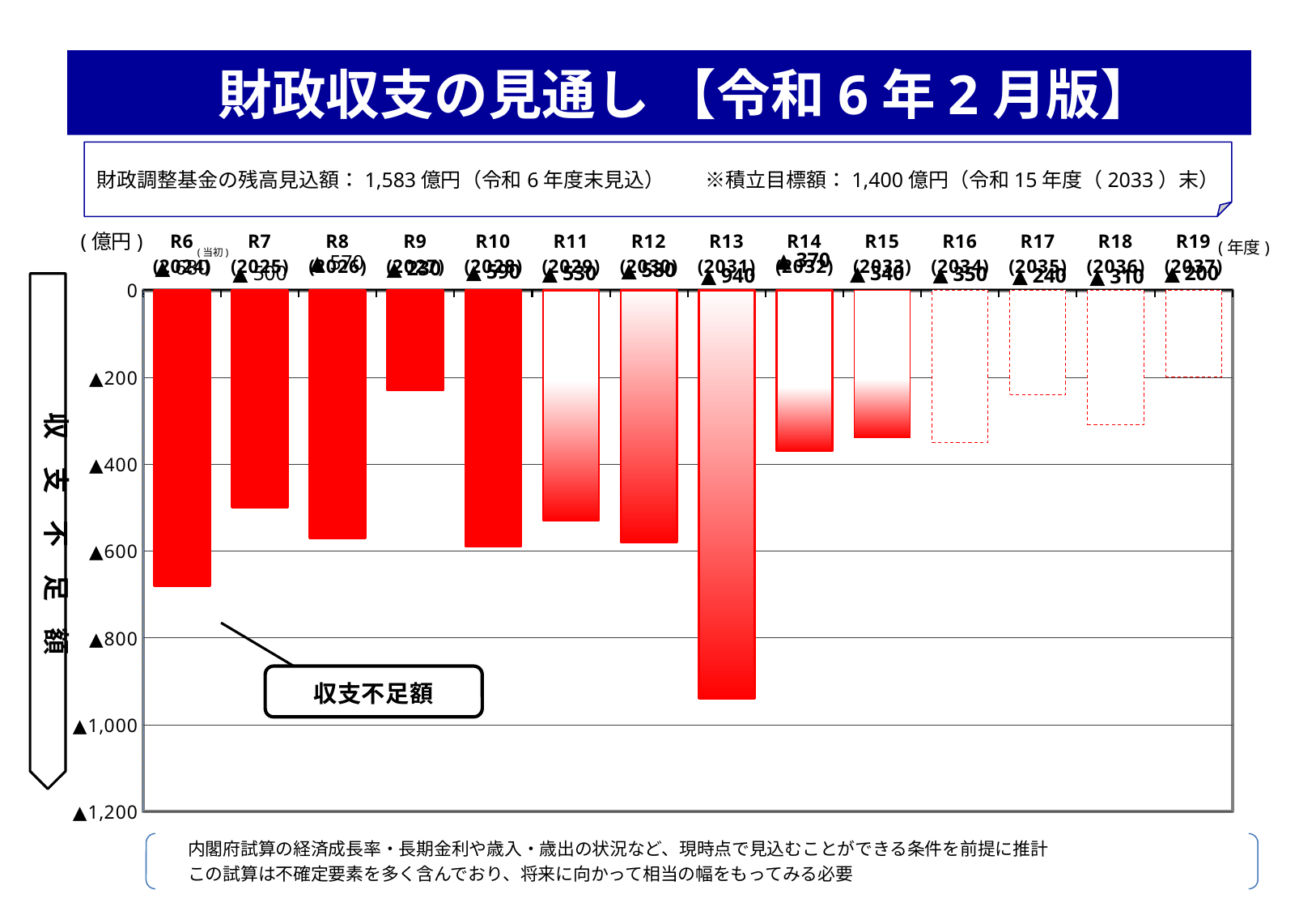
Which fiscal year has the largest shortfall (longest bar)? R13 (2031) What is the value shown for R19 (2037)? ▲200 What is the title of the slide containing the chart? 財政収支の見通し【令和6年2月版】 What is the value shown for R14 (2032)? ▲370 Which has the larger shortfall, R7 (2025) or R8 (2026)? R8 (2026) How many fiscal years (categories) are plotted on the chart? 14 Is the shortfall for R6 (2024) greater or less than 600 (億円)? greater Which fiscal year has the smallest shortfall (shortest bar)? R19 (2037) What is the value shown for R13 (2031)? ▲940 What is the value shown for R9 (2027)? ▲230 By how much does the shortfall for R13 (2031) exceed that for R12 (2030)? 360 What kind of chart is shown on the slide? bar chart